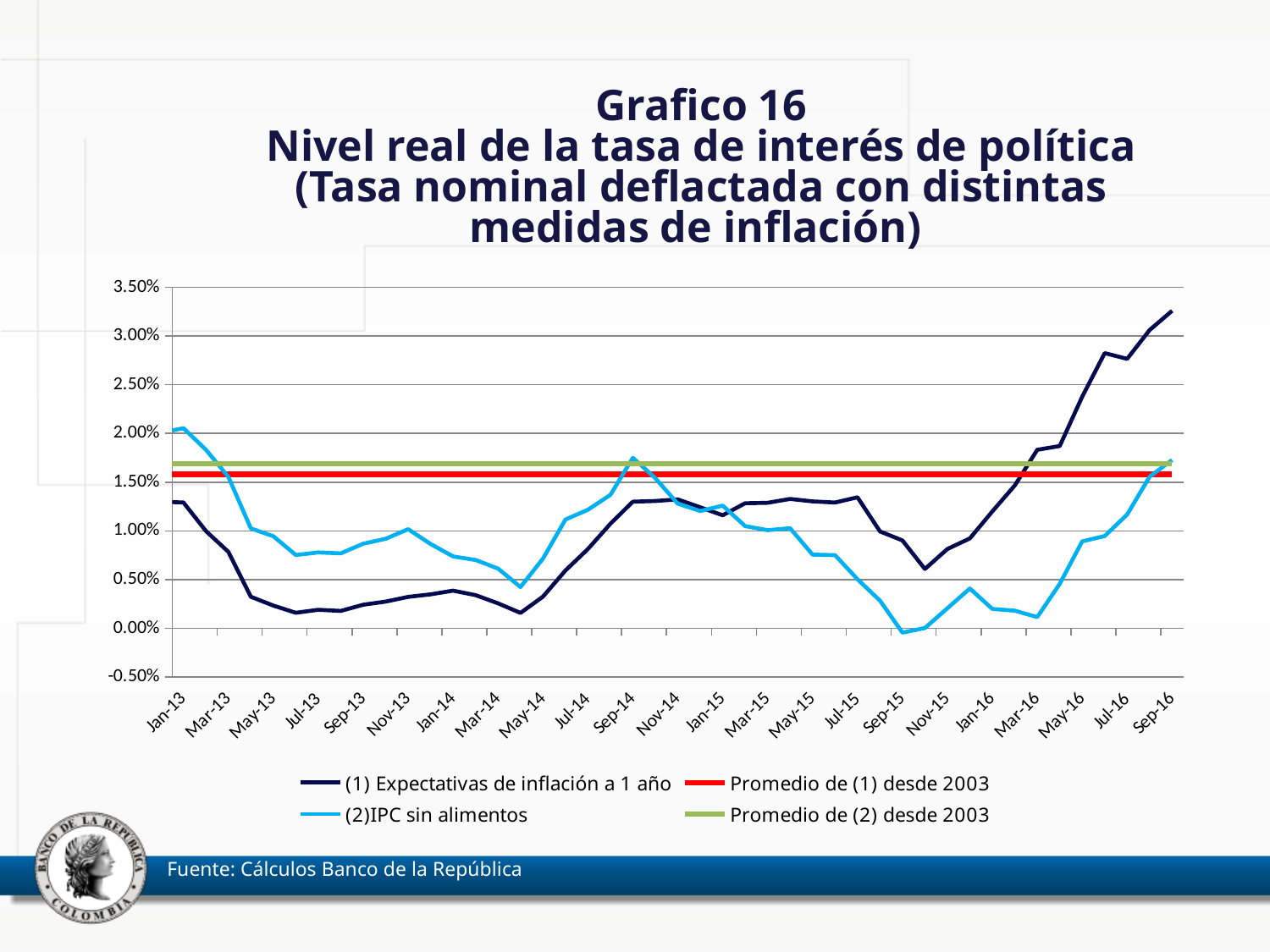
Is the value of (1) Expectativas de inflación a 1 año at Sep-16 greater or less than 3.00%? greater Is the value of (2) IPC sin alimentos at Jan-13 greater or less than 1.50%? greater Which series is drawn as the red horizontal line? Promedio de (1) desde 2003 What type of chart is shown on the slide? line chart At Sep-16, which series is higher: (1) Expectativas de inflación a 1 año or (2) IPC sin alimentos? (1) Expectativas de inflación a 1 año Is the value of (1) Expectativas de inflación a 1 año at Jul-13 greater or less than 0.50%? less What is the chart number given in the title? Grafico 16 How many series does the legend list? 4 Does the (2) IPC sin alimentos line rise or fall between Jan-13 and Jul-13? fall Does the (1) Expectativas de inflación a 1 año line rise or fall between Mar-16 and Sep-16? rise At Jan-13, which series is higher: (1) Expectativas de inflación a 1 año or (2) IPC sin alimentos? (2) IPC sin alimentos